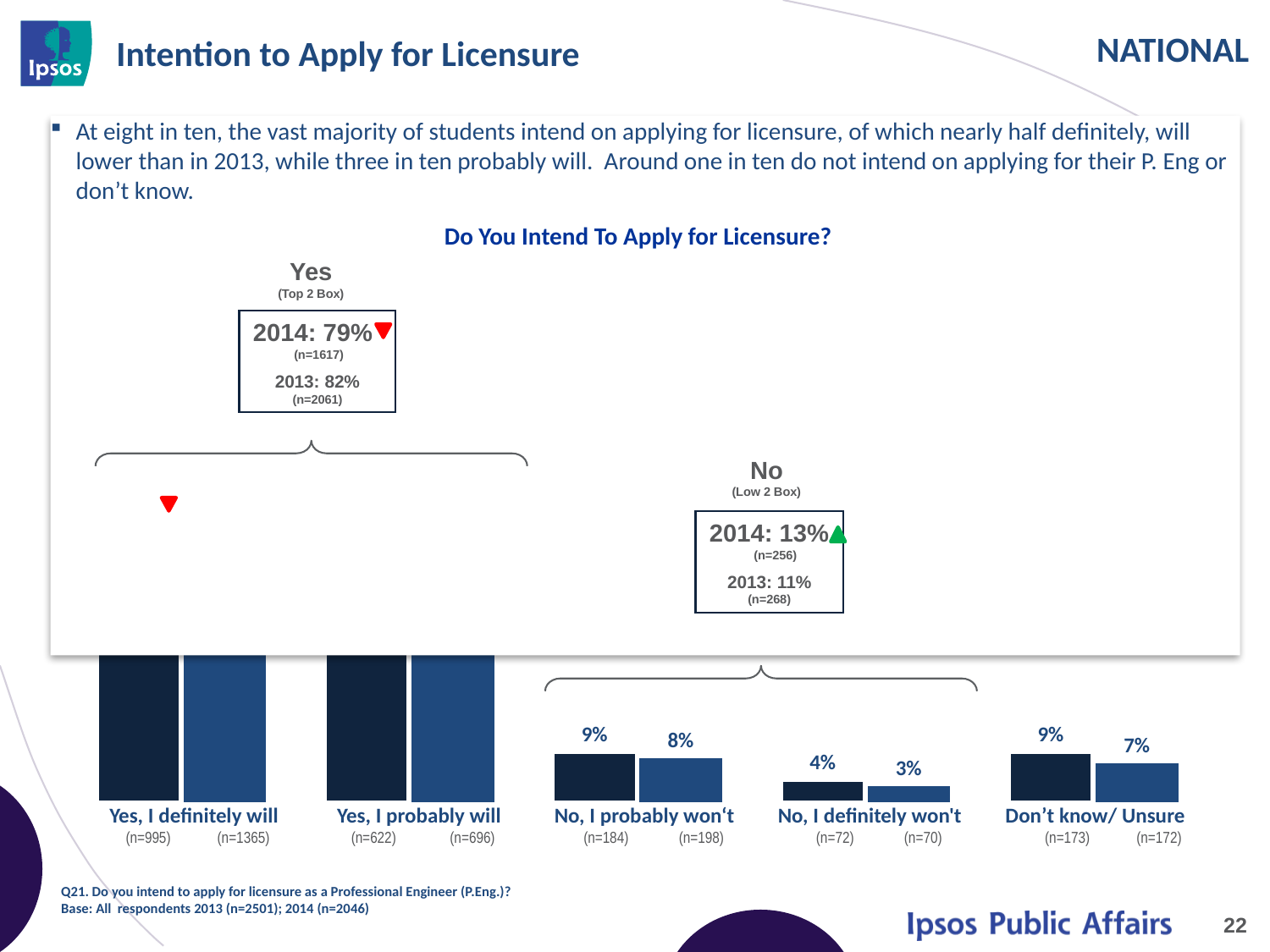
What is the value of the lighter (right) bar for "Don't know/ Unsure"? 7% According to the "Yes (Top 2 Box)" box, what was the 2014 percentage? 79% What is the difference between the darker and lighter bars for "Don't know/ Unsure"? 2 percentage points What is the value of the lighter (right) bar for "No, I probably won't"? 8% Which is larger: the lighter bar for "No, I probably won't" or the lighter bar for "Don't know/ Unsure"? No, I probably won't What is the difference between the 2013 and 2014 "Yes (Top 2 Box)" percentages? 3 percentage points What is the value of the darker (left) bar for "No, I definitely won't"? 4% What kind of chart is shown under the title "Do You Intend To Apply for Licensure?"? bar chart Which response category has the lowest values in the chart? No, I definitely won't According to the "No (Low 2 Box)" box, what was the 2013 percentage? 11% What is the value of the darker (left) bar for "No, I probably won't"? 9% How many response categories are shown along the bottom of the chart? 5